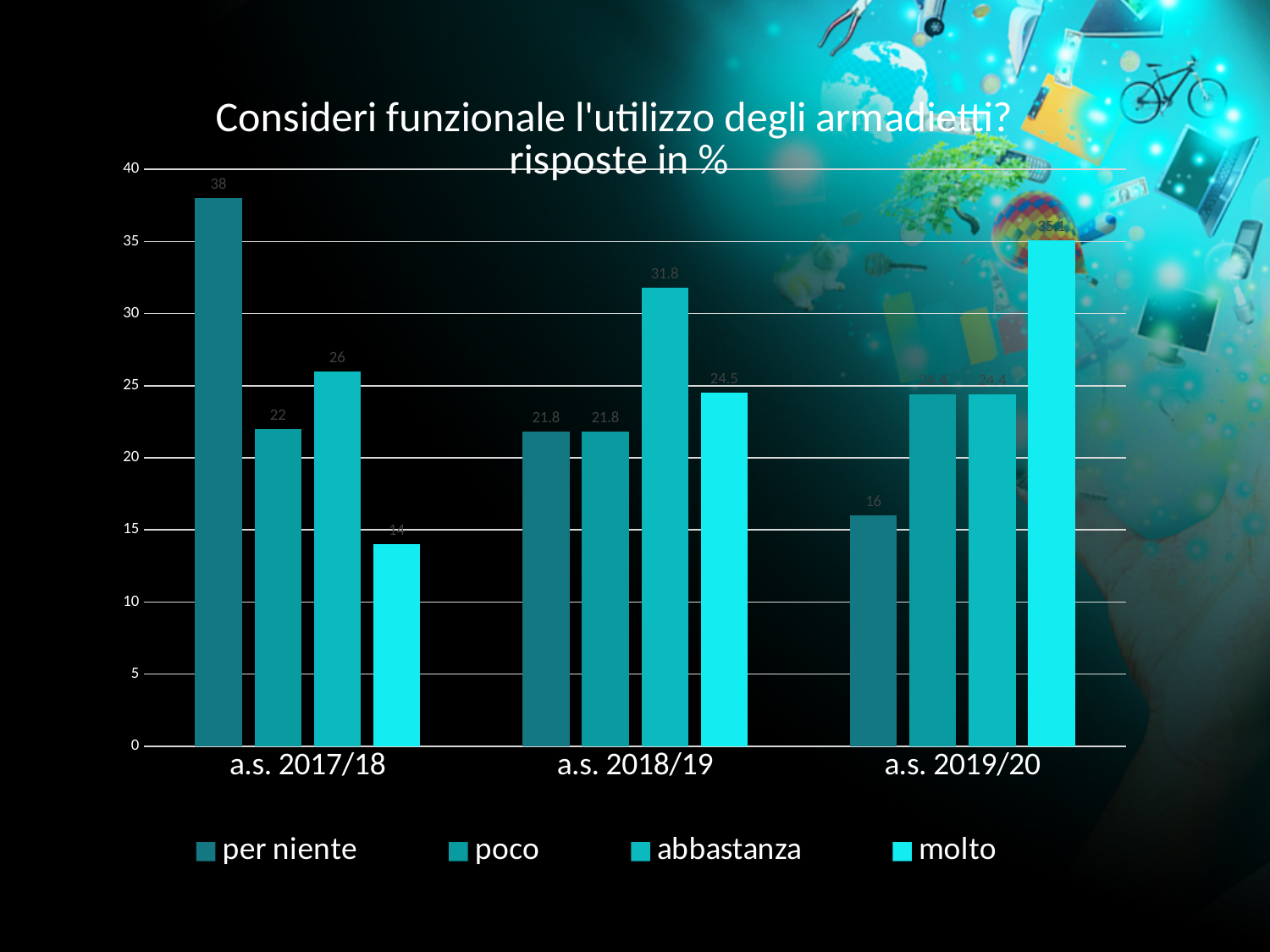
What is the value for 'per niente' in a.s. 2019/20? 16 Is the value for 'molto' in a.s. 2019/20 greater or less than 30? greater Which response has the highest value in a.s. 2017/18? per niente What is the value for 'molto' in a.s. 2017/18? 14 Which response has the lowest value in a.s. 2017/18? molto How many series does the legend list? 4 What is the value for 'per niente' in a.s. 2017/18? 38 Does the value for 'per niente' rise or fall from a.s. 2017/18 to a.s. 2019/20? fall What is the value for 'abbastanza' in a.s. 2018/19? 31.8 What is the difference between 'per niente' and 'poco' in a.s. 2017/18? 16 How many school years (categories) are shown on the x axis? 3 In a.s. 2018/19, which is larger: 'abbastanza' or 'molto'? abbastanza